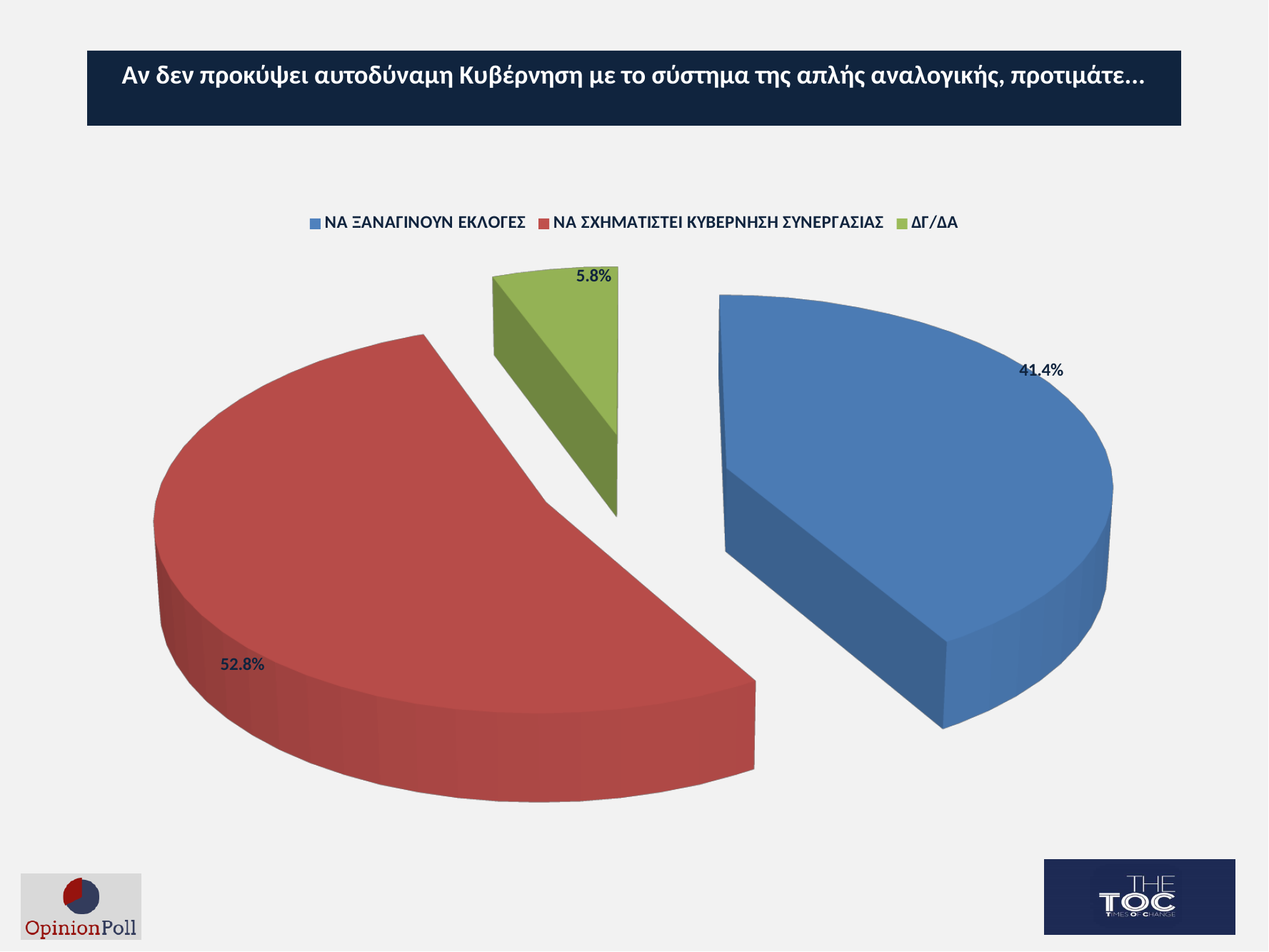
Which is larger: the share for ΝΑ ΞΑΝΑΓΙΝΟΥΝ ΕΚΛΟΓΕΣ or the share for ΔΓ/ΔΑ? ΝΑ ΞΑΝΑΓΙΝΟΥΝ ΕΚΛΟΓΕΣ What percentage is shown for ΝΑ ΣΧΗΜΑΤΙΣΤΕΙ ΚΥΒΕΡΝΗΣΗ ΣΥΝΕΡΓΑΣΙΑΣ? 52.8% How many slices does the pie chart have? 3 What kind of chart is shown on the slide? Pie chart What colour is the slice for ΝΑ ΞΑΝΑΓΙΝΟΥΝ ΕΚΛΟΓΕΣ? Blue How many entries does the legend list? 3 Which category has the smallest share of the pie? ΔΓ/ΔΑ What percentage is shown for ΝΑ ΞΑΝΑΓΙΝΟΥΝ ΕΚΛΟΓΕΣ? 41.4% What colour is the slice for ΔΓ/ΔΑ? Green What percentage is shown for ΔΓ/ΔΑ? 5.8% Which category has the largest share of the pie? ΝΑ ΣΧΗΜΑΤΙΣΤΕΙ ΚΥΒΕΡΝΗΣΗ ΣΥΝΕΡΓΑΣΙΑΣ What is the difference in percentage points between ΝΑ ΣΧΗΜΑΤΙΣΤΕΙ ΚΥΒΕΡΝΗΣΗ ΣΥΝΕΡΓΑΣΙΑΣ and ΝΑ ΞΑΝΑΓΙΝΟΥΝ ΕΚΛΟΓΕΣ? 11.4